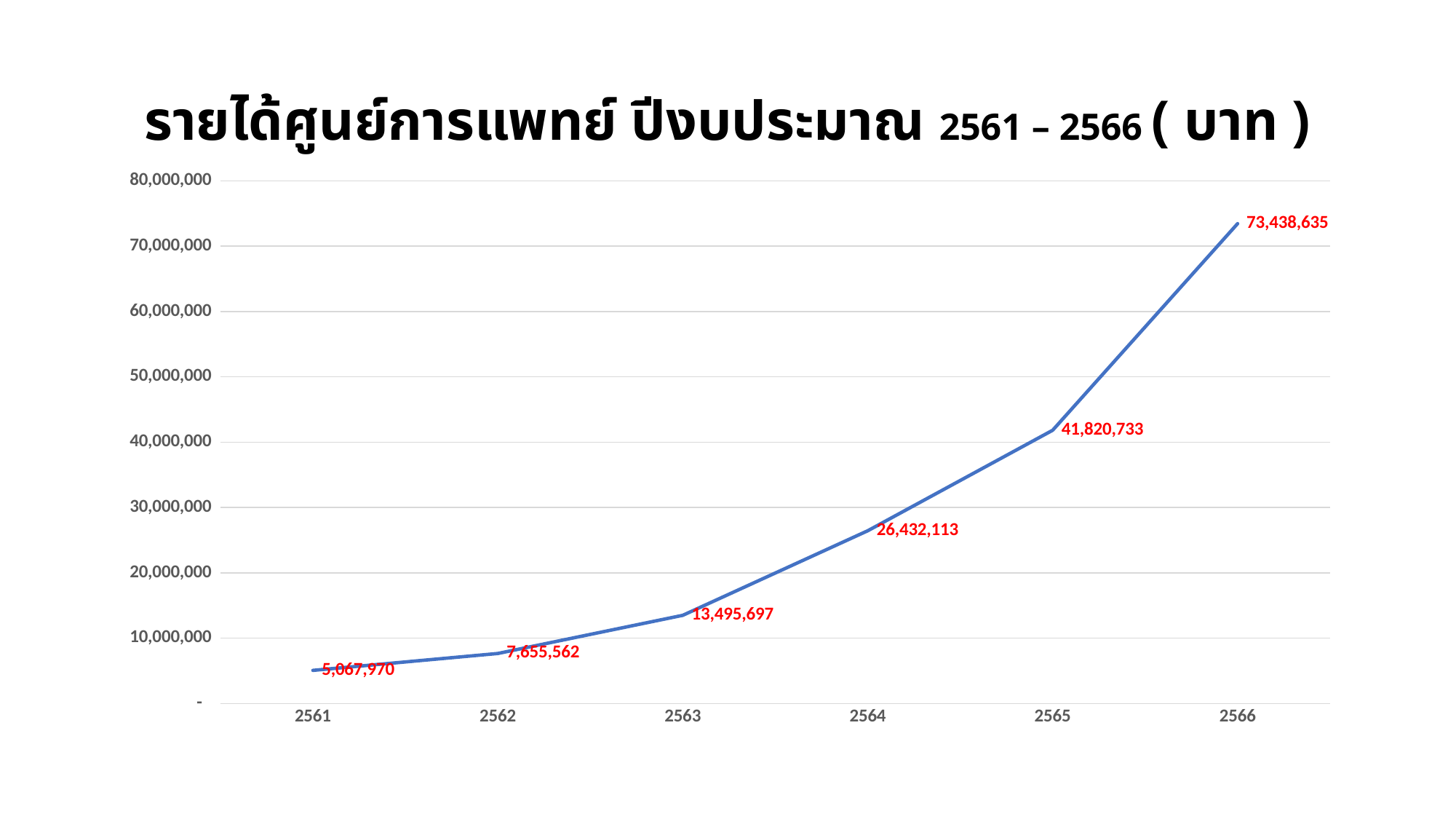
What is the difference between the values for 2562 and 2561? 2,587,592 What is the value for 2563? 13,495,697 What is the value for 2561? 5,067,970 What kind of chart is shown on the slide? Line chart Which year has the highest value? 2566 How many years are plotted on the chart? 6 What is the value for 2564? 26,432,113 What is the value for 2566? 73,438,635 Do the values rise or fall from 2561 to 2566? Rise What is the difference between the values for 2566 and 2565? 31,617,902 Which is larger, the value for 2565 or the value for 2564? 2565 Which year has the lowest value? 2561